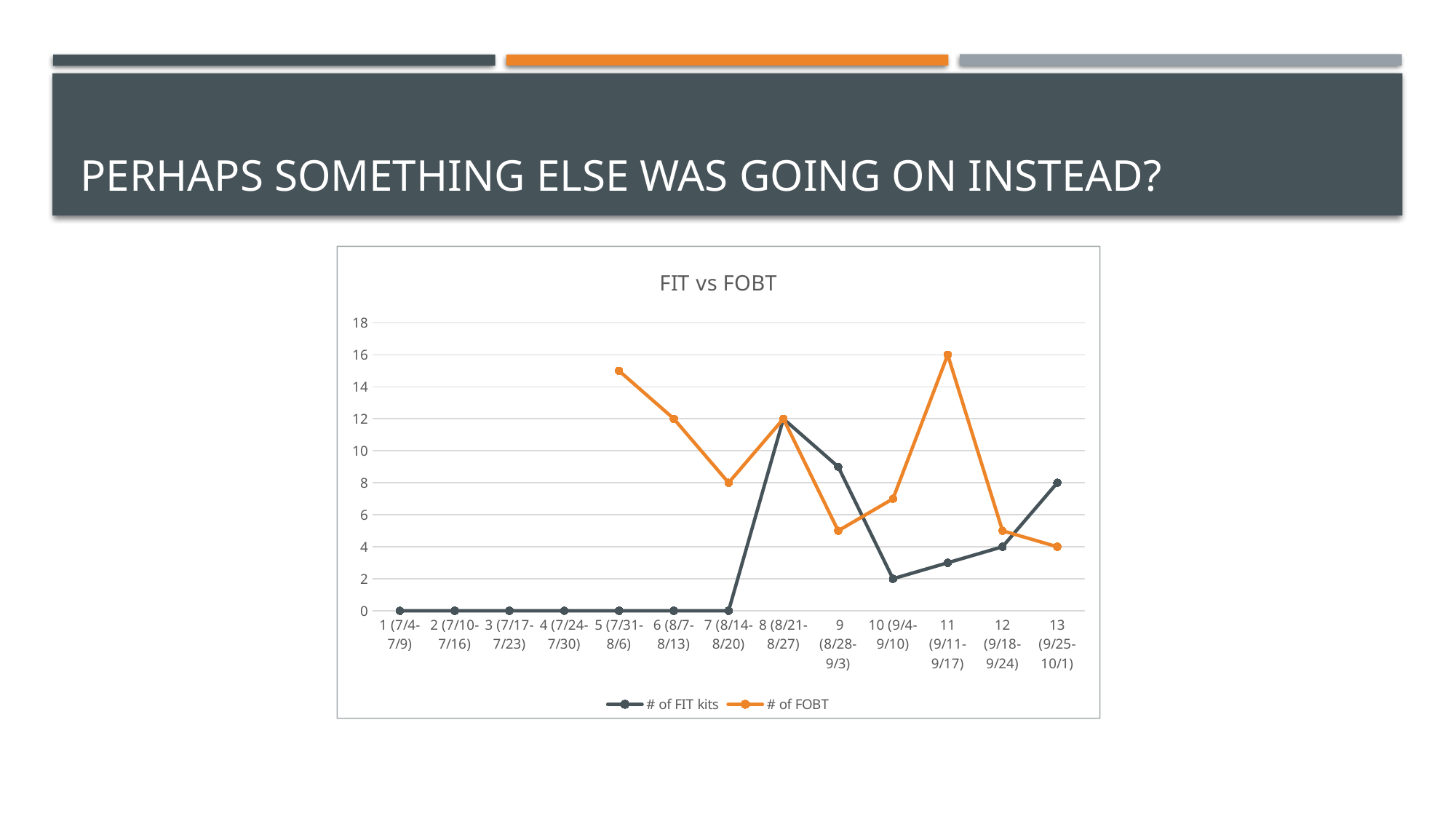
How many weeks are shown on the x axis? 13 What is the value of # of FIT kits in week 8 (8/21-8/27)? 12 What is the title of the chart? FIT vs FOBT In which week does # of FOBT reach its highest value? 11 (9/11-9/17) What kind of chart is shown on the slide? line chart Is the value of # of FOBT in week 5 (7/31-8/6) greater or less than 10? greater What is the value of # of FIT kits in week 13 (9/25-10/1)? 8 In week 10 (9/4-9/10), which series has the larger value, # of FIT kits or # of FOBT? # of FOBT How many series does the legend list? 2 What is the value of # of FOBT in week 11 (9/11-9/17)? 16 In which week does # of FIT kits reach its highest value? 8 (8/21-8/27) What is the difference between # of FOBT in week 6 (8/7-8/13) and week 7 (8/14-8/20)? 4